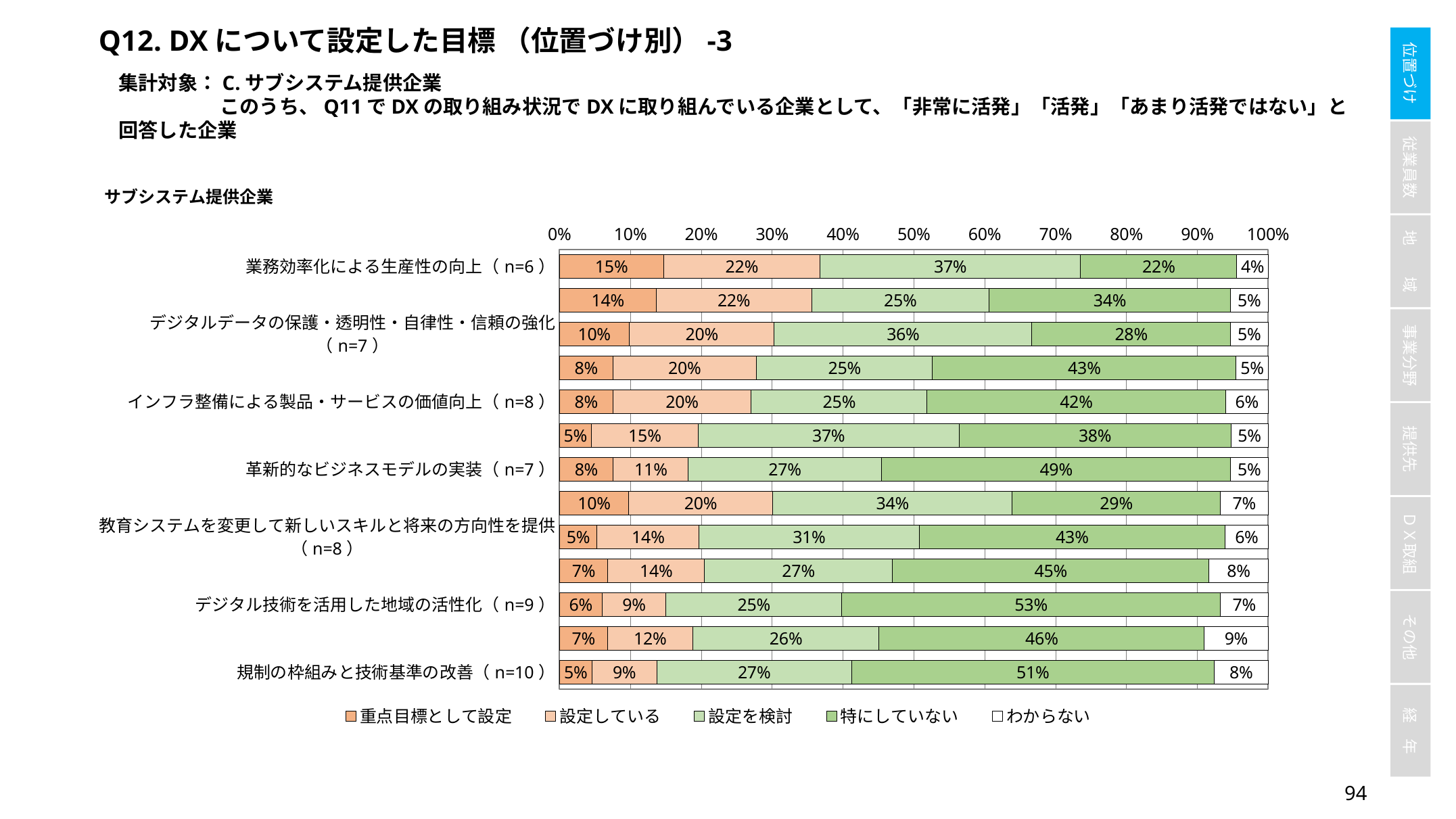
What is the value of 特にしていない for 革新的なビジネスモデルの実装（n=7）? 49% What is the value of 重点目標として設定 for 業務効率化による生産性の向上（n=6）? 15% What is the value of 設定を検討 for 業務効率化による生産性の向上（n=6）? 37% How many bars are plotted in the chart? 13 What kind of chart is shown on the slide? Stacked bar chart What is the value of 特にしていない for デジタル技術を活用した地域の活性化（n=9）? 53% What is the difference between 特にしていない and 設定を検討 for 規制の枠組みと技術基準の改善（n=10）? 24% Which is larger for 業務効率化による生産性の向上（n=6）: 重点目標として設定 or 設定している? 設定している What is the value of 特にしていない for 規制の枠組みと技術基準の改善（n=10）? 51% What is the value of わからない for 規制の枠組みと技術基準の改善（n=10）? 8% Which legend entry is shown in the darkest green colour? 特にしていない How many series does the legend list? 5